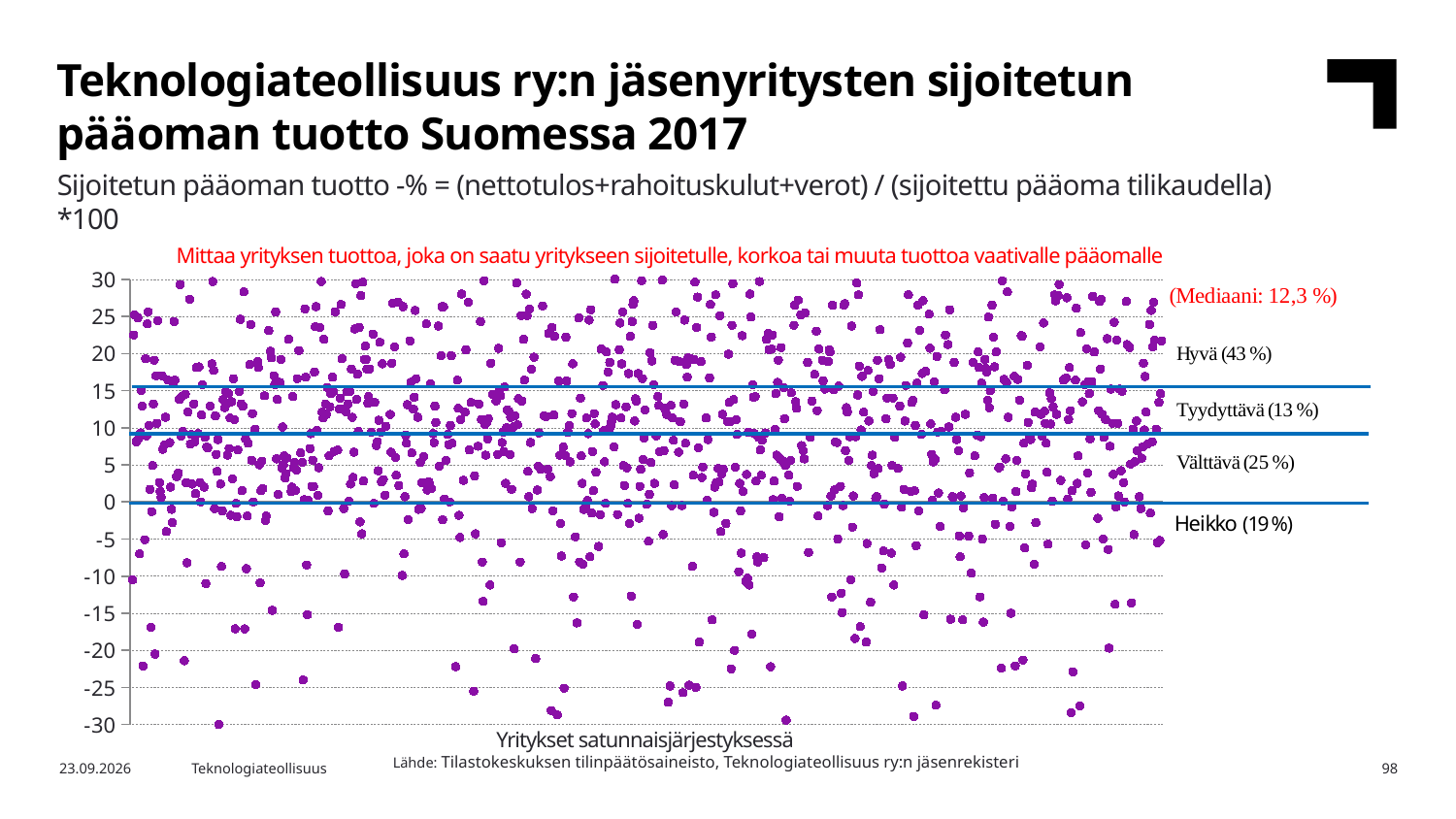
What kind of chart is shown on the slide? Scatter chart What is the median return on invested capital (Mediaani) shown on the chart? 12,3 % What share of companies falls into the Tyydyttävä category? 13 % What share of companies falls into the Hyvä category? 43 % Which category has the largest share of companies? Hyvä What share of companies falls into the Välttävä category? 25 % What is the difference in percentage points between the Hyvä share and the Tyydyttävä share? 30 percentage points How many rating categories are labelled on the right side of the chart? 4 Which category has the smallest share of companies? Tyydyttävä What is the label of the x axis? Yritykset satunnaisjärjestyksessä Which category has a larger share of companies, Välttävä or Heikko? Välttävä What share of companies falls into the Heikko category? 19 %